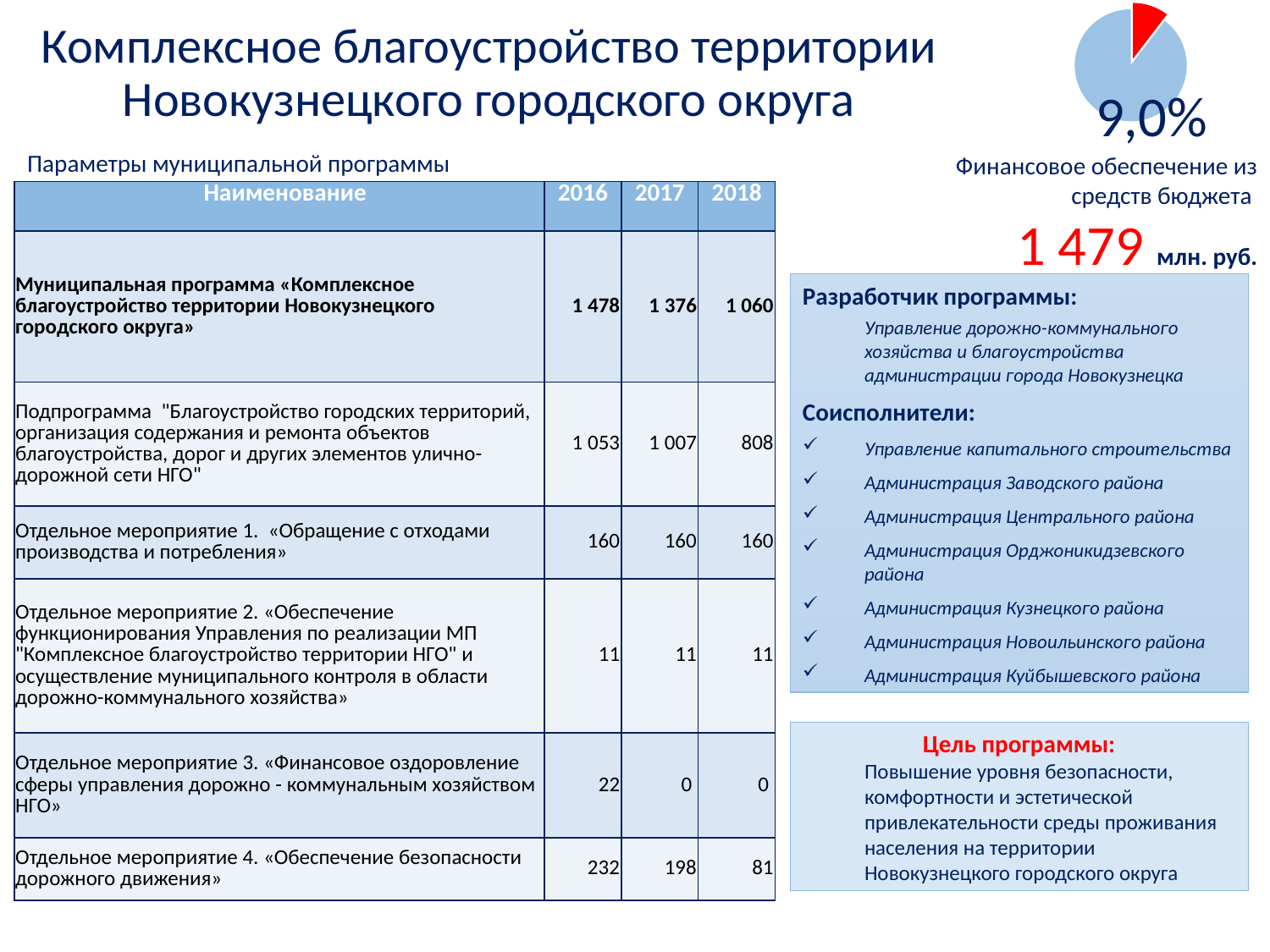
What share of the pie chart in the top right corner does the red slice represent? 9,0% What caption appears directly below the pie chart in the top right corner of the slide? Финансовое обеспечение из средств бюджета In the pie chart in the top right corner, which slice is larger, the red one or the light blue one? the light blue one What colour is the slice labelled 9,0% in the pie chart in the top right corner? red What percentage is printed on the pie chart in the top right corner of the slide? 9,0% What kind of chart is shown in the top right corner of the slide? pie chart In the pie chart in the top right corner, which slice is the smallest? the red slice How many slices does the pie chart in the top right corner of the slide have? 2